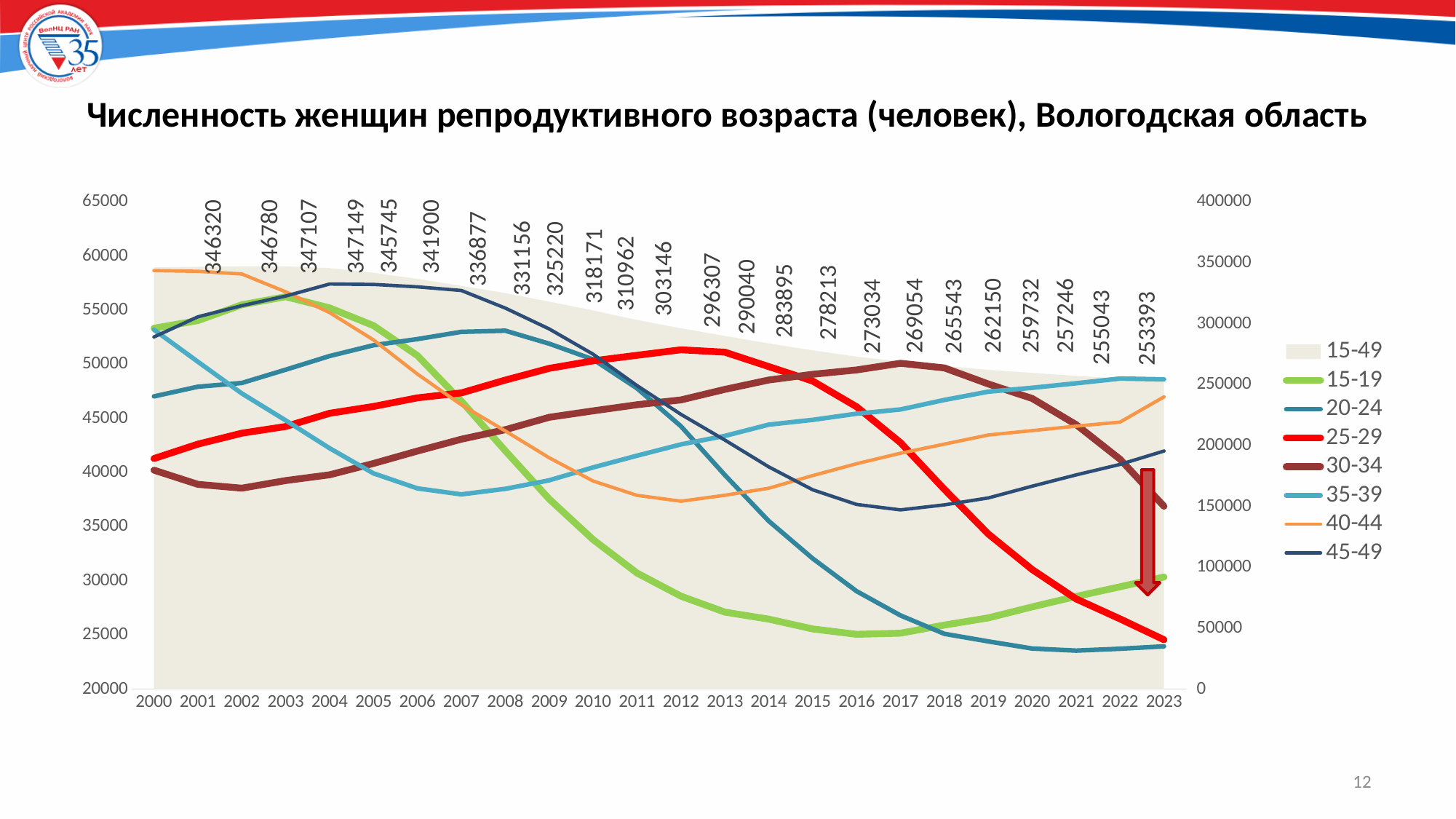
How many years are shown on the x axis? 24 Is the value for the 40-44 series in 2000 greater or less than 55000? greater In which year is the 15-49 series at its highest? 2003 What is the difference between the 15-49 values in 2003 and 2023? 93756 In 2023, which is larger: the 15-19 series or the 20-24 series? 15-19 Is the value for the 20-24 series in 2021 greater or less than 25000? less What is the value of the 15-49 series in 2000? 346320 How many series does the legend list? 8 Does the 15-49 series rise or fall from 2005 to 2023? fall What is the value of the 15-49 series in 2023? 253393 What is the value of the 15-49 series in 2012? 296307 In which year is the 15-49 series at its lowest? 2023